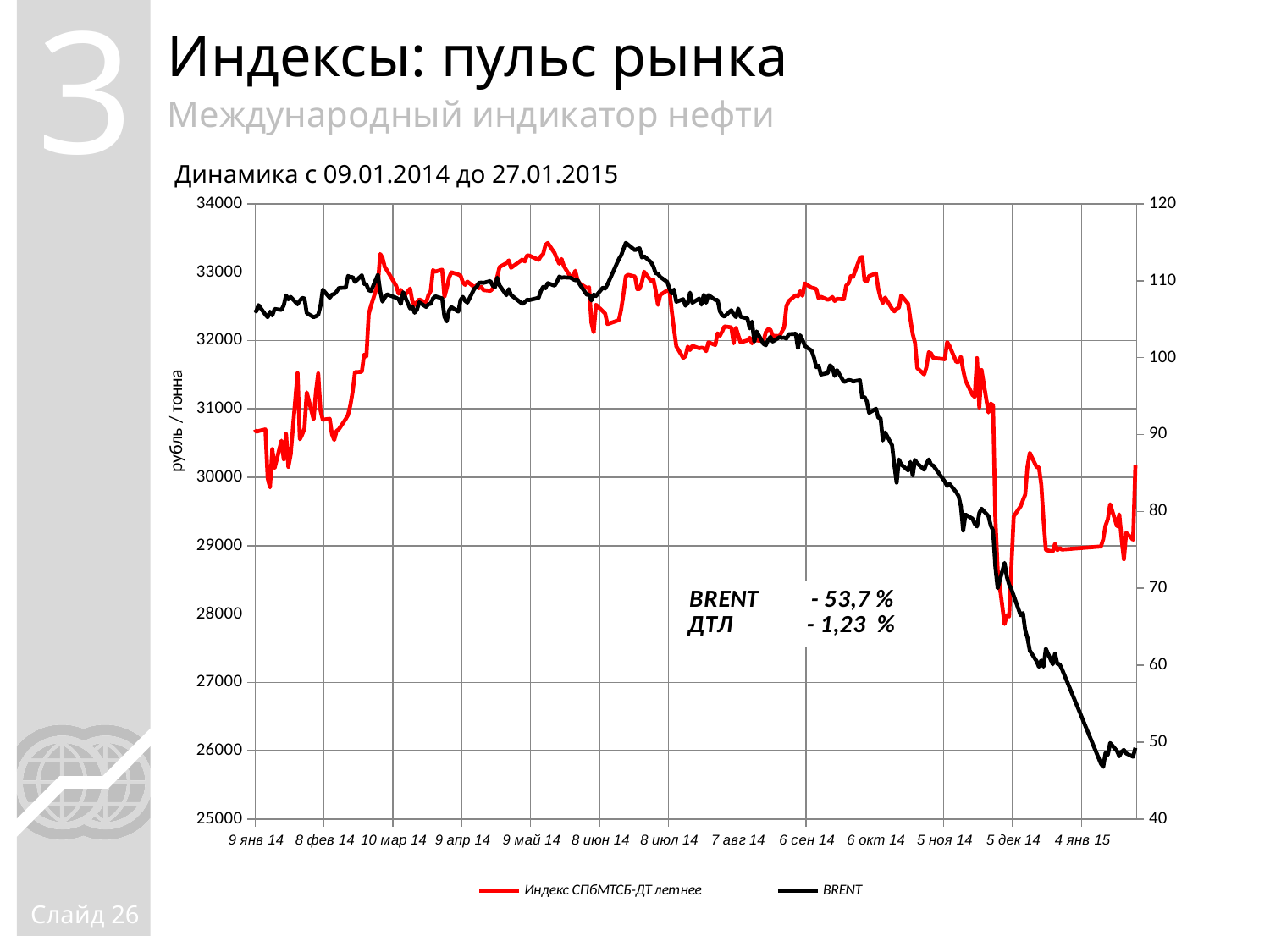
Which colour is used for the BRENT line in the legend? black What percentage change is shown for ДТЛ in the annotation on the chart? - 1,23 % Does the BRENT line rise or fall overall from 9 янв 14 to 4 янв 15? fall How many series does the legend list? 2 What is the label of the left vertical axis? рубль / тонна Is the BRENT value at the start of the period (9 янв 14) greater or less than 100 on the right axis? greater Is the Индекс СПбМТСБ-ДТ летнее value at 9 янв 14 greater or less than 30000 on the left axis? greater Is the lowest point of the Индекс СПбМТСБ-ДТ летнее line (around 5 дек 14) greater or less than 29000 on the left axis? less What kind of chart is shown on the slide? line chart What percentage change is shown for BRENT in the annotation on the chart? - 53,7 % Which series shows the larger percentage decline according to the annotation, BRENT or ДТЛ? BRENT